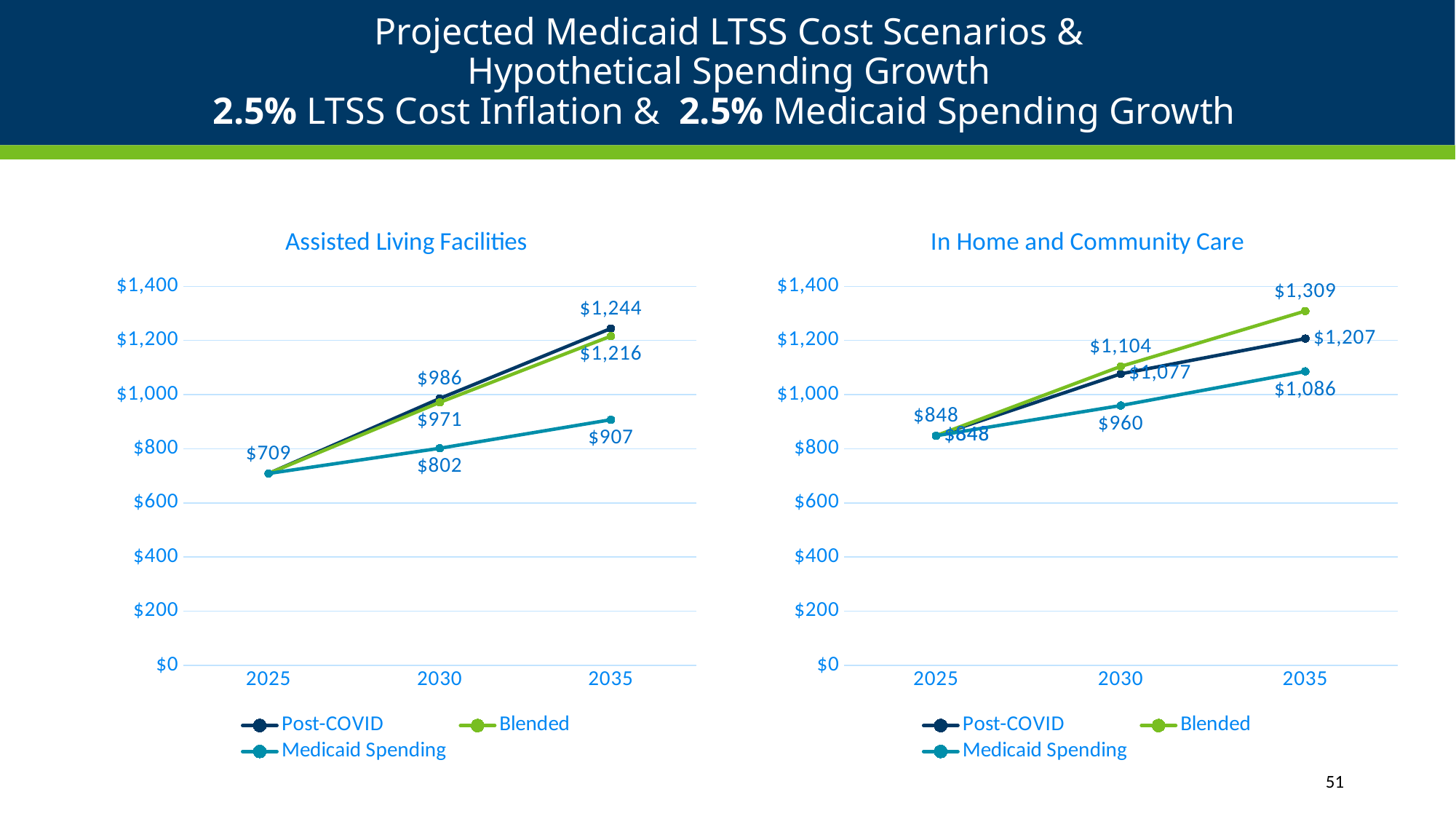
In the In Home and Community Care chart, which series has the lowest value in 2030? Medicaid Spending In the Assisted Living Facilities chart, what is the Medicaid Spending value in 2030? $802 In the Assisted Living Facilities chart, what is the Post-COVID value in 2035? $1,244 In the Assisted Living Facilities chart, what is the difference between the Post-COVID and Medicaid Spending values in 2035? $337 How many series does the legend of the Assisted Living Facilities chart list? 3 In the In Home and Community Care chart, do the Post-COVID values rise or fall from 2025 to 2035? Rise In the In Home and Community Care chart, what is the Blended value in 2035? $1,309 In the Assisted Living Facilities chart, which series has the highest value in 2035? Post-COVID What kind of chart is the In Home and Community Care chart? Line chart How many years are shown on the x axis of the Assisted Living Facilities chart? 3 In the In Home and Community Care chart, what is the Medicaid Spending value in 2035? $1,086 In the In Home and Community Care chart, which is larger in 2035, Blended or Post-COVID? Blended